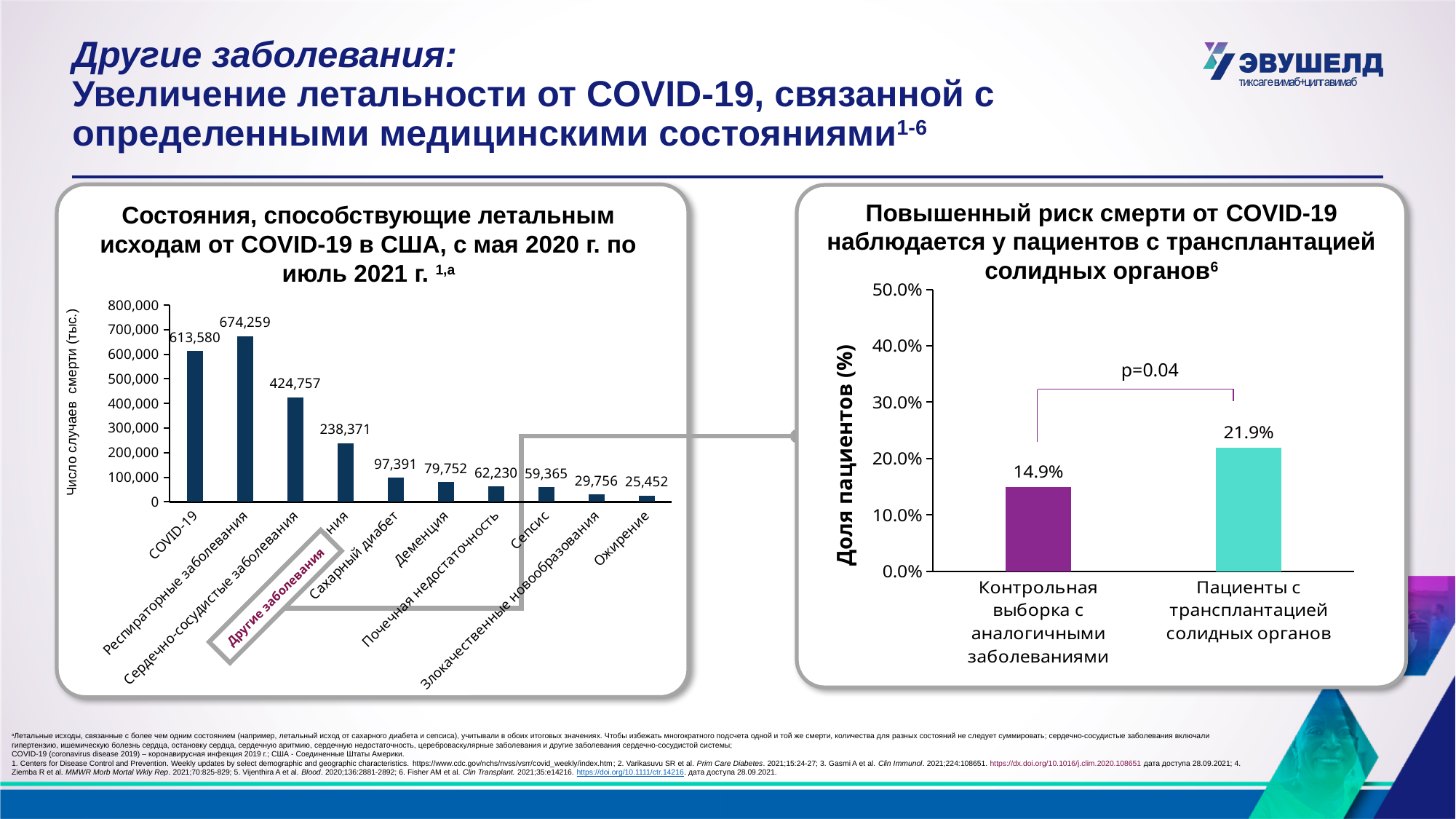
In the right chart, what p-value is shown above the bars? p=0.04 In the left chart, which category has the lowest value? Ожирение In the left chart, which category has the highest value? Респираторные заболевания In the right chart, what is the difference between the two bars? 7.0% In the left chart, what is the value for Сахарный диабет? 97,391 In the left chart, what is the difference between the values for Респираторные заболевания and COVID-19? 60,679 In the right chart (Повышенный риск смерти от COVID-19), what is the value for Пациенты с трансплантацией солидных органов? 21.9% In the left chart, how many categories are shown on the x axis? 10 What type of chart is the left chart? Bar chart In the left chart, which is larger: the value for Деменция or the value for Сепсис? Деменция In the left chart (Состояния, способствующие летальным исходам от COVID-19 в США), what is the value for Респираторные заболевания? 674,259 In the right chart, what is the value for Контрольная выборка с аналогичными заболеваниями? 14.9%